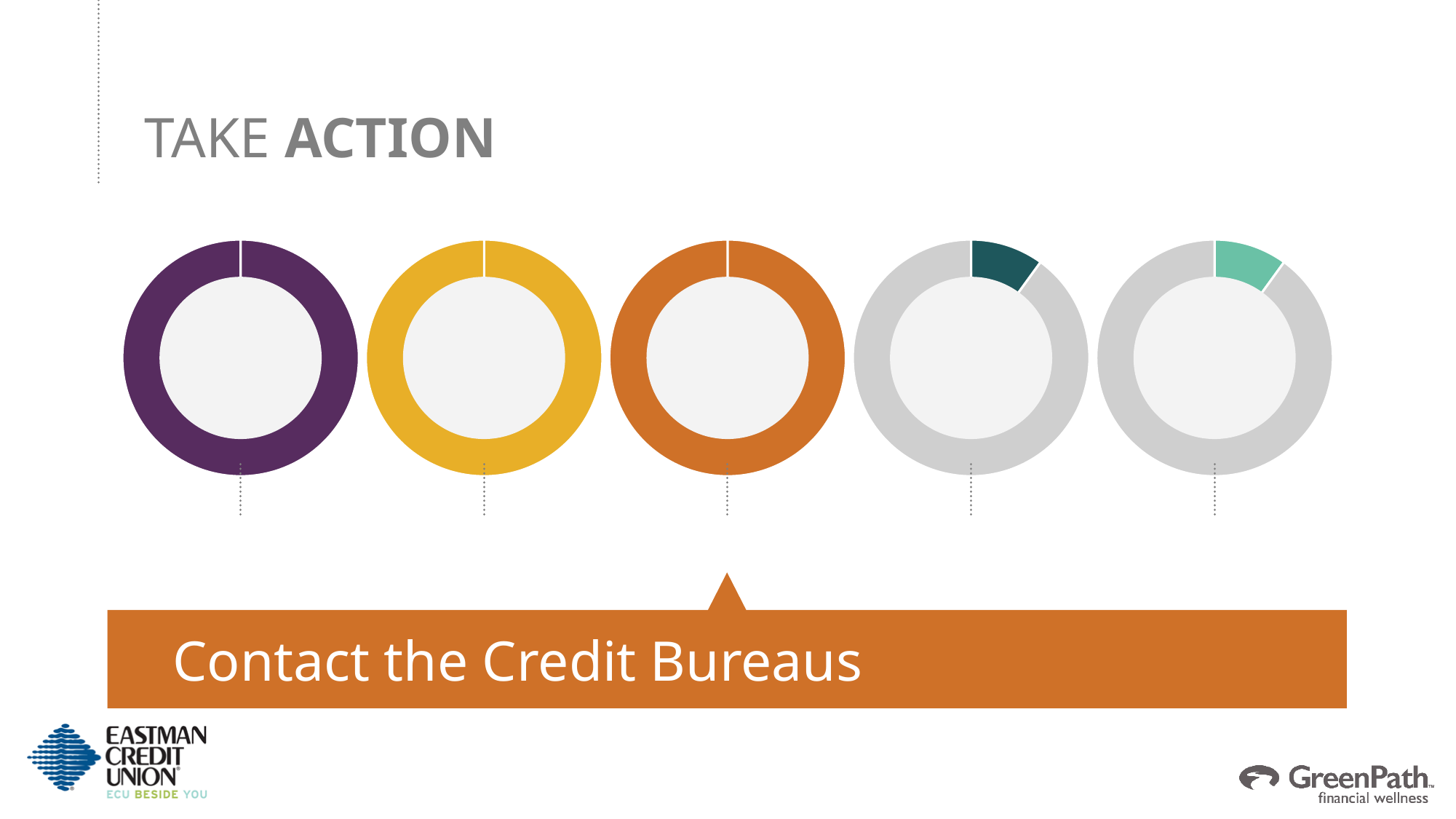
What colour is the ring of the leftmost donut chart? purple Is the coloured portion of the leftmost donut chart larger or smaller than the coloured portion of the rightmost donut chart? larger Is the coloured portion of the third donut chart from the left larger or smaller than the coloured portion of the fourth donut chart from the left? larger How many donut charts are shown on the slide? 5 What kind of chart is repeated five times across the middle of the slide? donut chart Which donut chart, counting from the left, does the pointer on the orange banner point to? the third